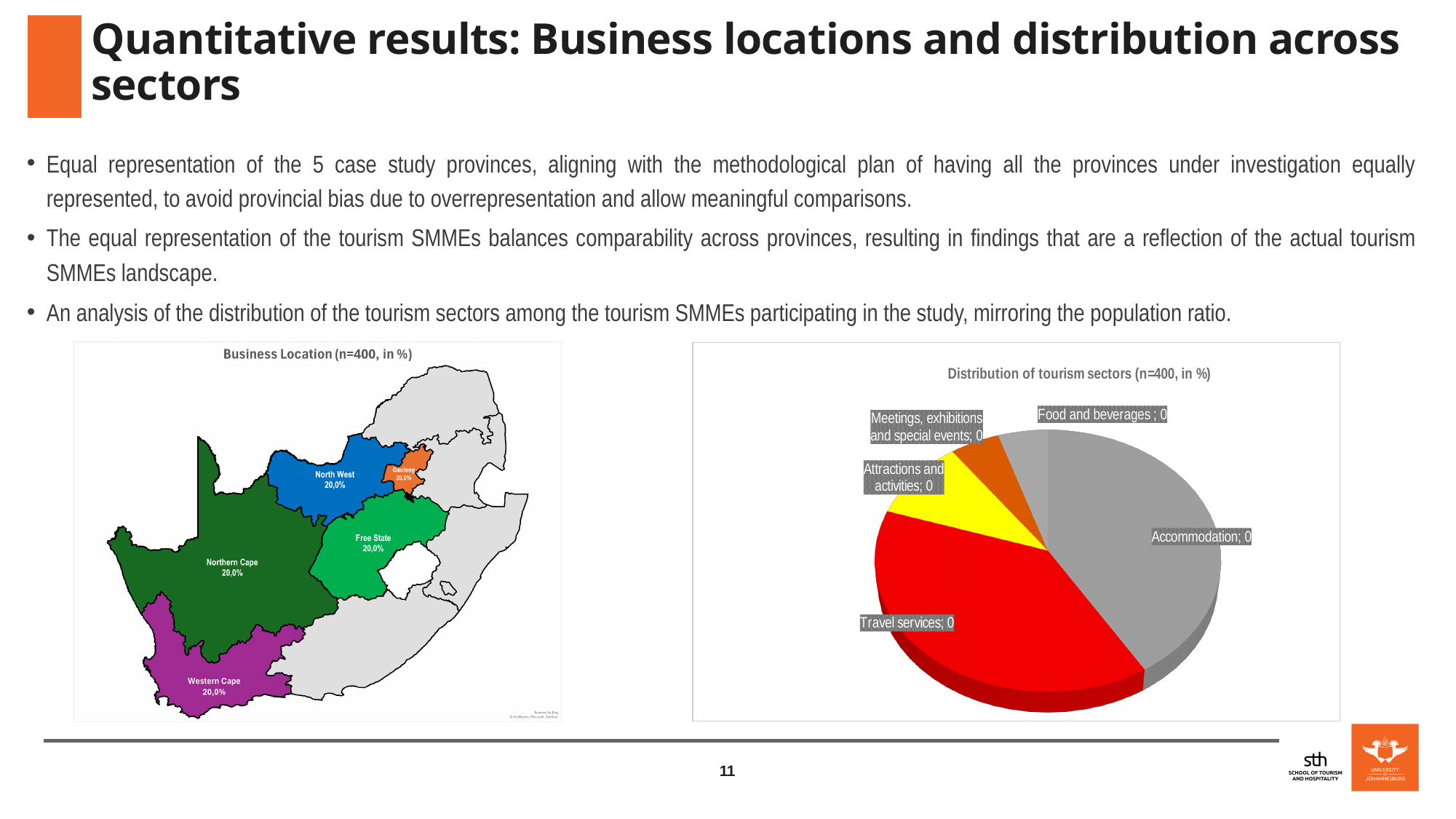
What kind of chart is the Distribution of tourism sectors chart? Pie chart On the Business Location chart, what is the value for Gauteng? 20,0% On the Business Location chart, how many provinces have a value shown? 5 On the Business Location chart, what is the value for North West? 20,0% On the Business Location chart, what is the value for Northern Cape? 20,0% On the Business Location chart, what is the value for Western Cape? 20,0% On the Distribution of tourism sectors chart, how many sectors are shown? 5 On the Distribution of tourism sectors chart, which slice is larger: Accommodation or Attractions and activities? Accommodation On the Distribution of tourism sectors chart, which sector has the largest slice? Accommodation On the Business Location chart, what is the difference between the values for Free State and Western Cape? 0,0% What is the title of the chart on the left of the slide? Business Location (n=400, in %)